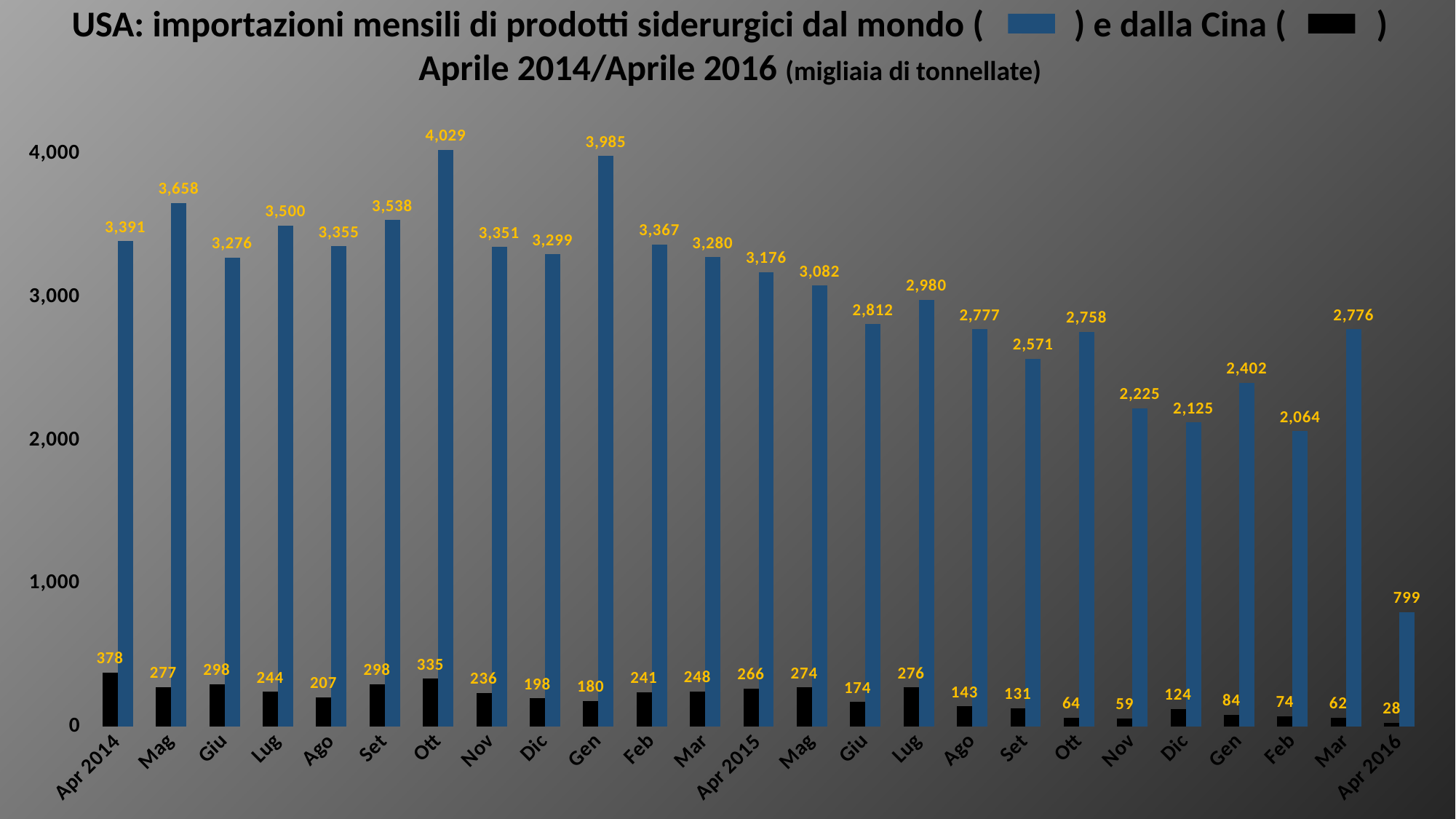
What kind of chart is shown on the slide? bar chart What is the value of US steel imports from the world (blue bar) in Apr 2015? 3,176 Which is larger: imports from China in Apr 2014 or in Apr 2015? Apr 2014 How many months (categories) are shown on the x axis? 25 What is the difference between imports from China in Apr 2014 and in Apr 2016? 350 In which month are imports from the world (blue bars) highest? Ott (October 2014), 4,029 How many data series does the chart show? 2 What is the value of US steel imports from China (black bar) in Apr 2014? 378 Is the value of imports from the world in Apr 2016 greater or less than 1,000? less What is the difference between imports from the world in Apr 2015 and in Apr 2016? 2,377 What is the value of US steel imports from China (black bar) in Apr 2016? 28 In which month are imports from the world (blue bars) lowest? Apr 2016